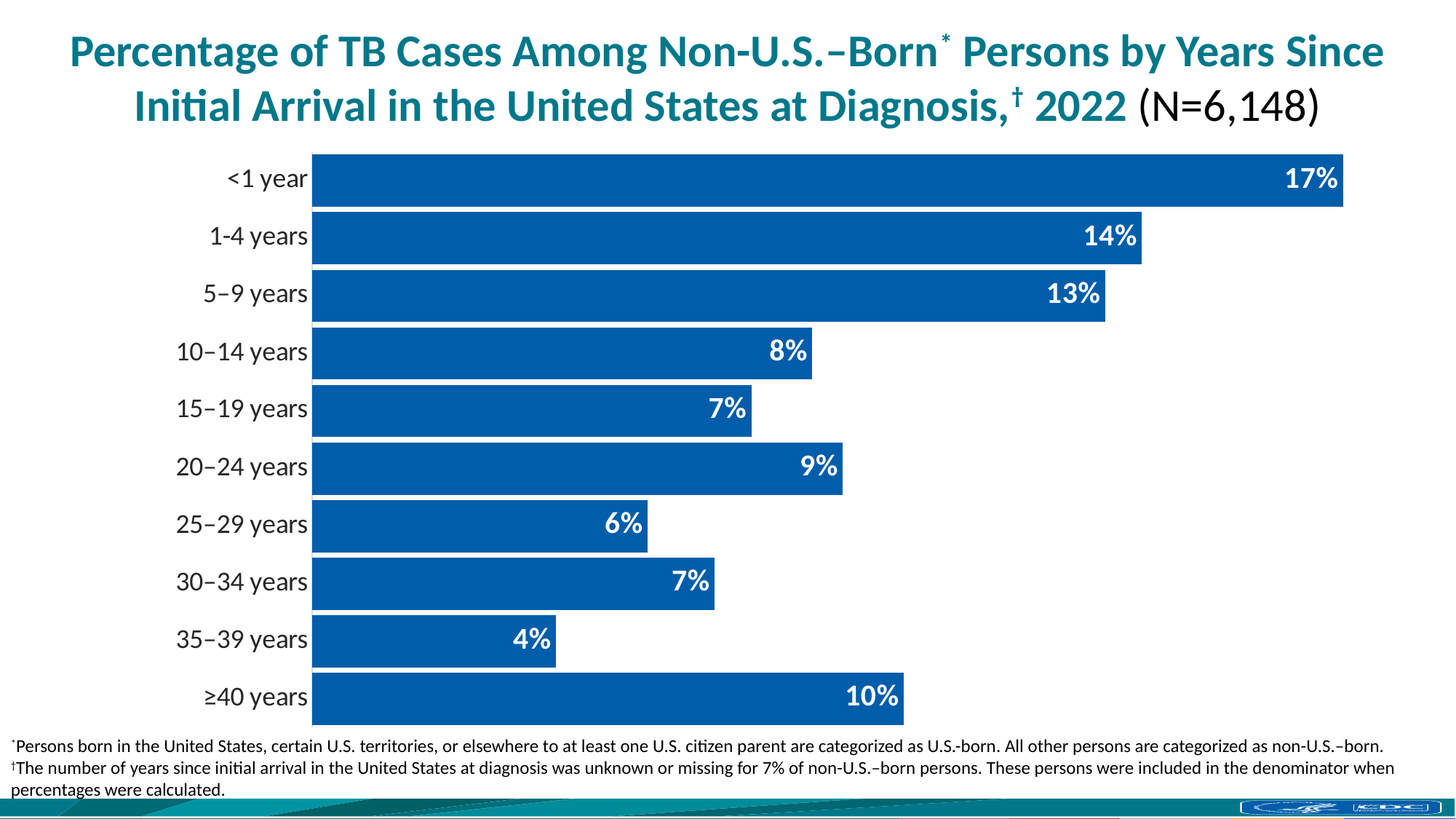
Which years-since-arrival category has the lowest percentage of TB cases? 35–39 years How many years-since-arrival categories are shown in the chart? 10 What percentage of TB cases is shown for the 20–24 years category? 9% What percentage of TB cases is shown for the ≥40 years category? 10% Which years-since-arrival category has the highest percentage of TB cases? <1 year What percentage of TB cases is shown for the <1 year category? 17% What is the total number of cases (N) stated in the chart title? 6,148 Which category has a larger percentage, 25–29 years or 30–34 years? 30–34 years Which category has a larger percentage, ≥40 years or 20–24 years? ≥40 years What type of chart is shown on the slide? Bar chart What is the difference in percentage points between the <1 year and 1-4 years categories? 3 What is the difference in percentage points between the 5–9 years and 10–14 years categories? 5